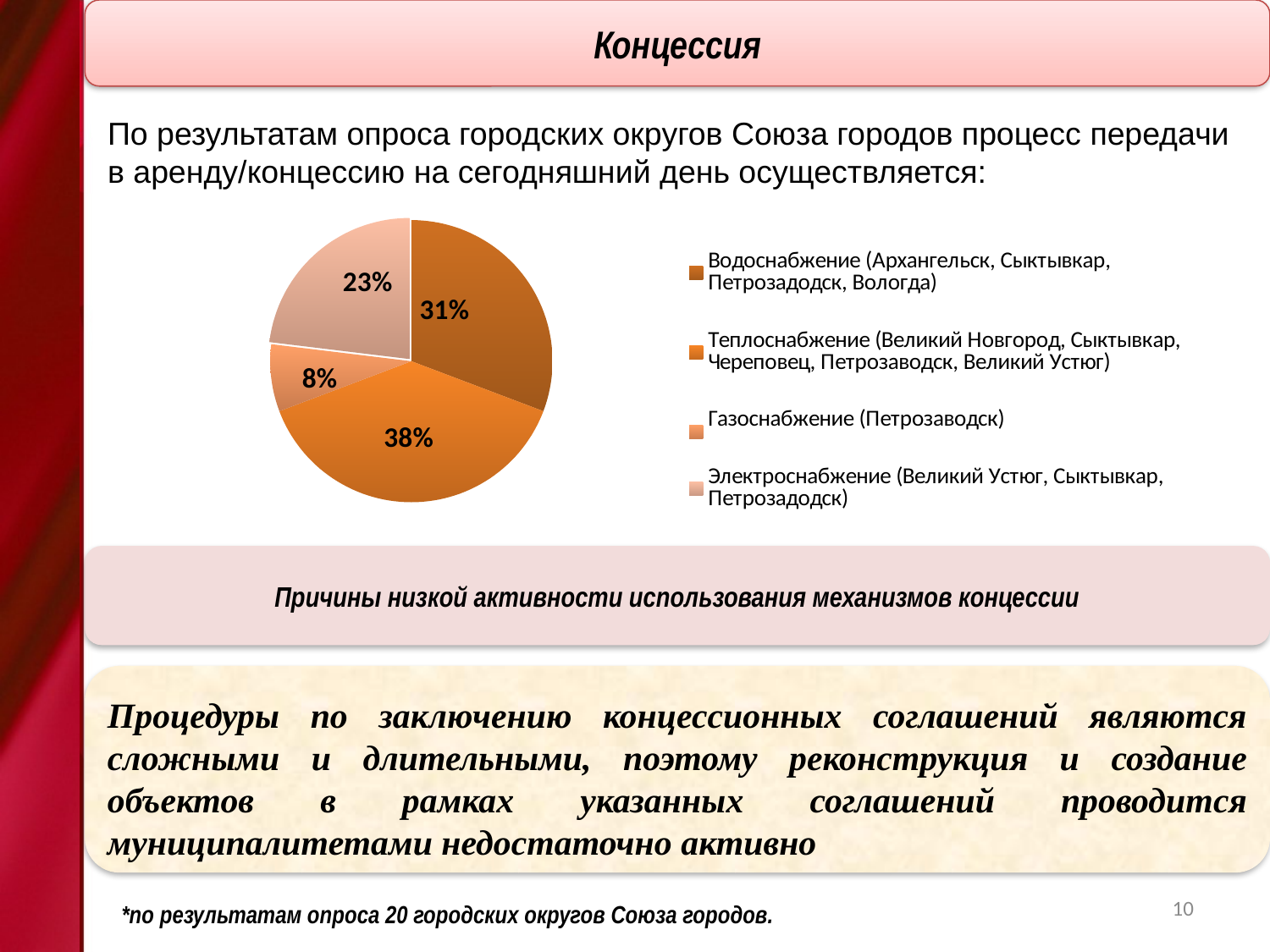
Which category has the smallest slice in the pie chart? Газоснабжение How many slices does the pie chart have? 4 What share of the pie chart does Теплоснабжение account for? 38% What share of the pie chart does Электроснабжение account for? 23% Which category has the largest slice in the pie chart? Теплоснабжение Which slice is larger: Электроснабжение or Газоснабжение? Электроснабжение Which city is listed in the legend for Газоснабжение? Петрозаводск What type of chart is shown on the slide? Pie chart How many entries does the legend of the pie chart list? 4 What share of the pie chart does Газоснабжение account for? 8% What share of the pie chart does Водоснабжение account for? 31% What is the difference in percentage points between the Теплоснабжение slice and the Водоснабжение slice? 7